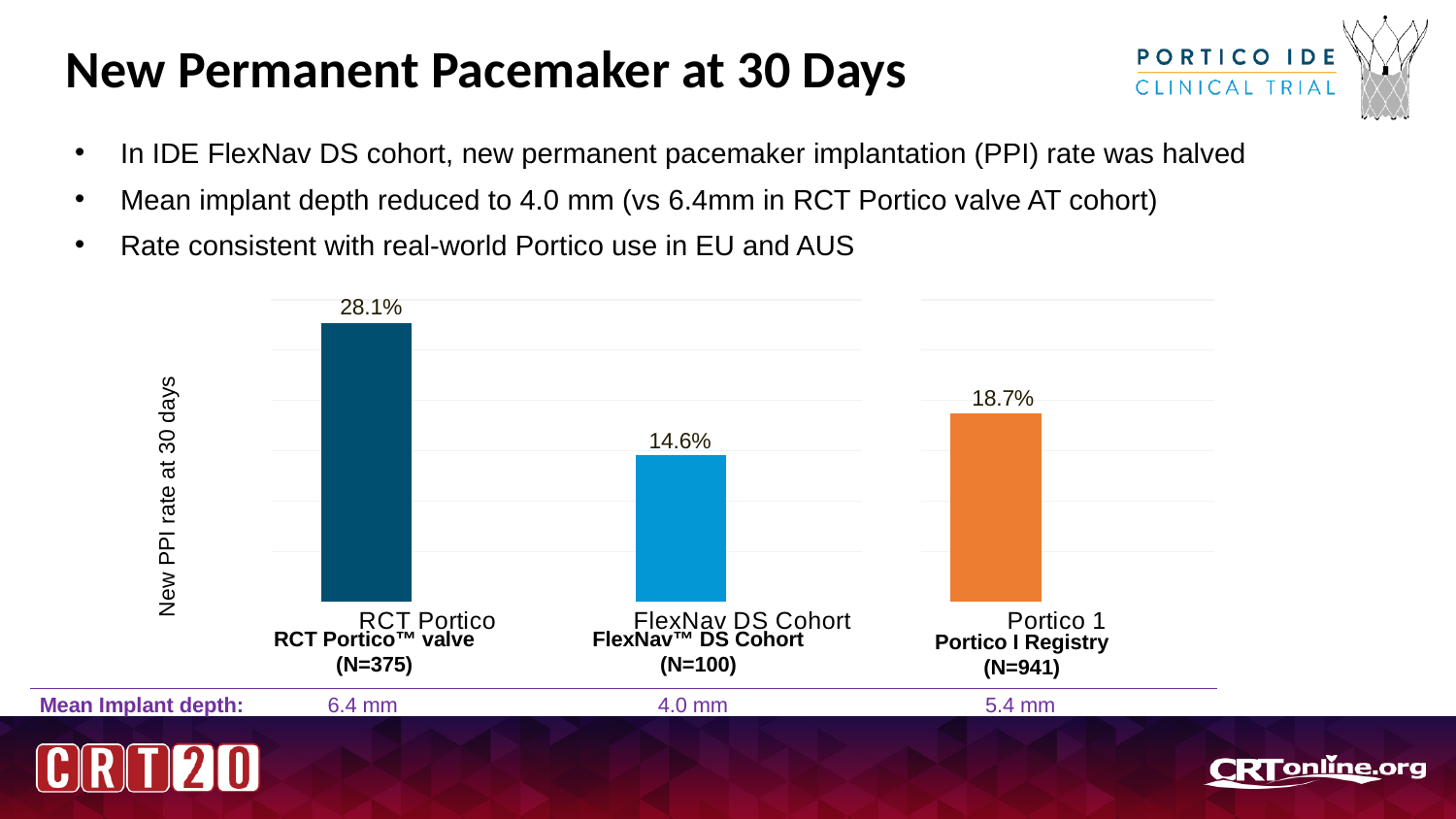
What is the difference in new PPI rate between the Portico I Registry and the FlexNav DS Cohort? 4.1% What is the new PPI rate at 30 days for the Portico I Registry? 18.7% What is the new PPI rate at 30 days for the FlexNav DS Cohort? 14.6% What is the difference in new PPI rate between the RCT Portico valve cohort and the FlexNav DS Cohort? 13.5% Which cohort has the lowest new PPI rate at 30 days? FlexNav DS Cohort What type of chart is shown on the slide? Bar chart How many cohorts are shown in the chart? 3 Which cohort has the highest new PPI rate at 30 days? RCT Portico valve What is the mean implant depth listed below the FlexNav DS Cohort bar? 4.0 mm What is the label of the vertical axis of the chart? New PPI rate at 30 days What is the new PPI rate at 30 days for the RCT Portico valve cohort? 28.1% Which has a higher new PPI rate: the Portico I Registry or the FlexNav DS Cohort? Portico I Registry